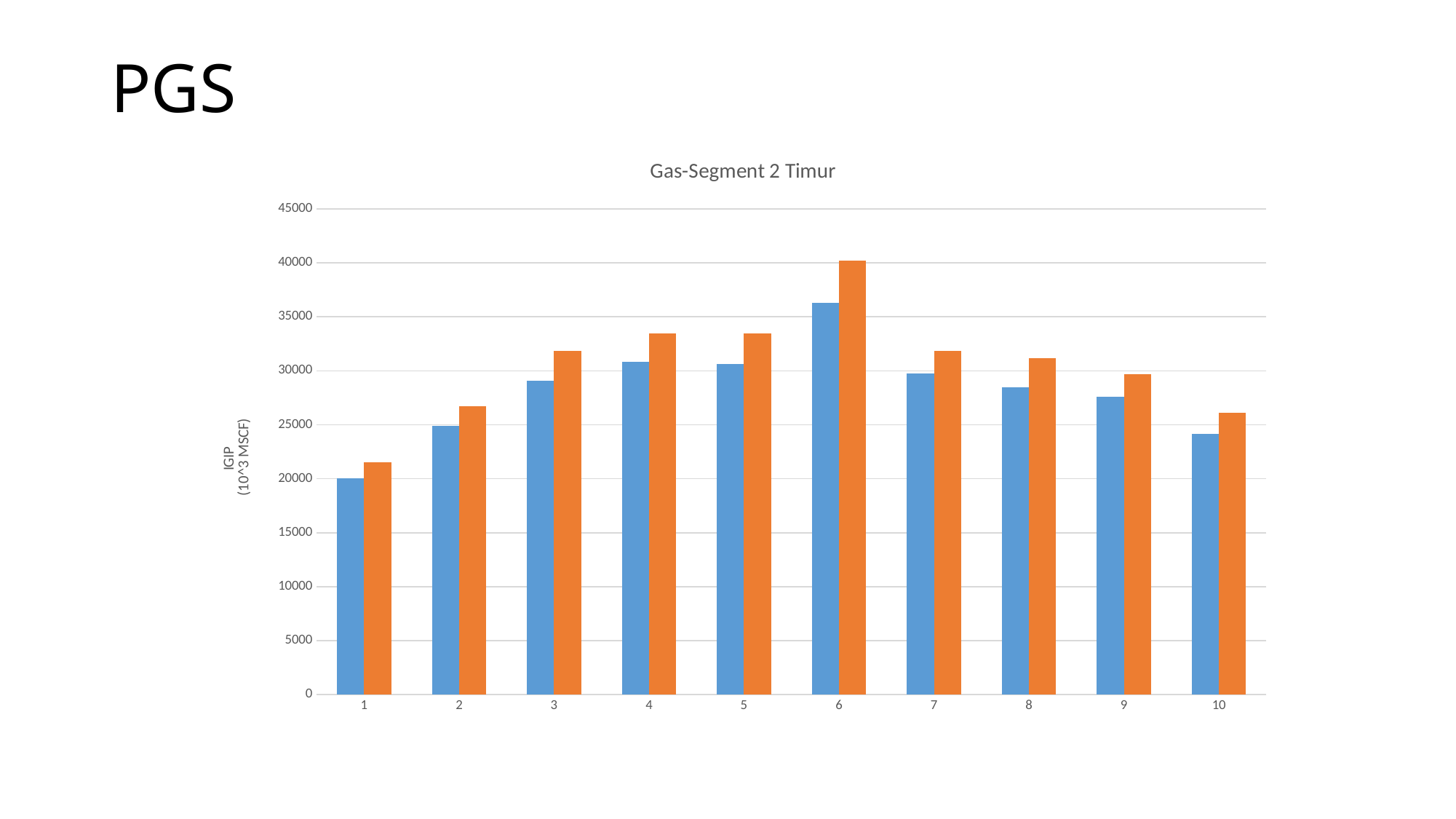
What is the title of the chart? Gas-Segment 2 Timur Do the blue bars rise or fall from category 6 to category 10? fall Is the blue bar for category 10 greater or less than 25000? less Is the orange bar for category 3 greater or less than 30000? greater How many categories are shown on the x axis of the chart? 10 Which category has the lowest blue bar? 1 How many bars are plotted for each category in the chart? 2 For category 2, which bar is taller, the blue one or the orange one? orange Which category has the highest orange bar? 6 What is the label of the vertical axis? IGIP (10^3 MSCF) What kind of chart is shown on the slide? bar chart